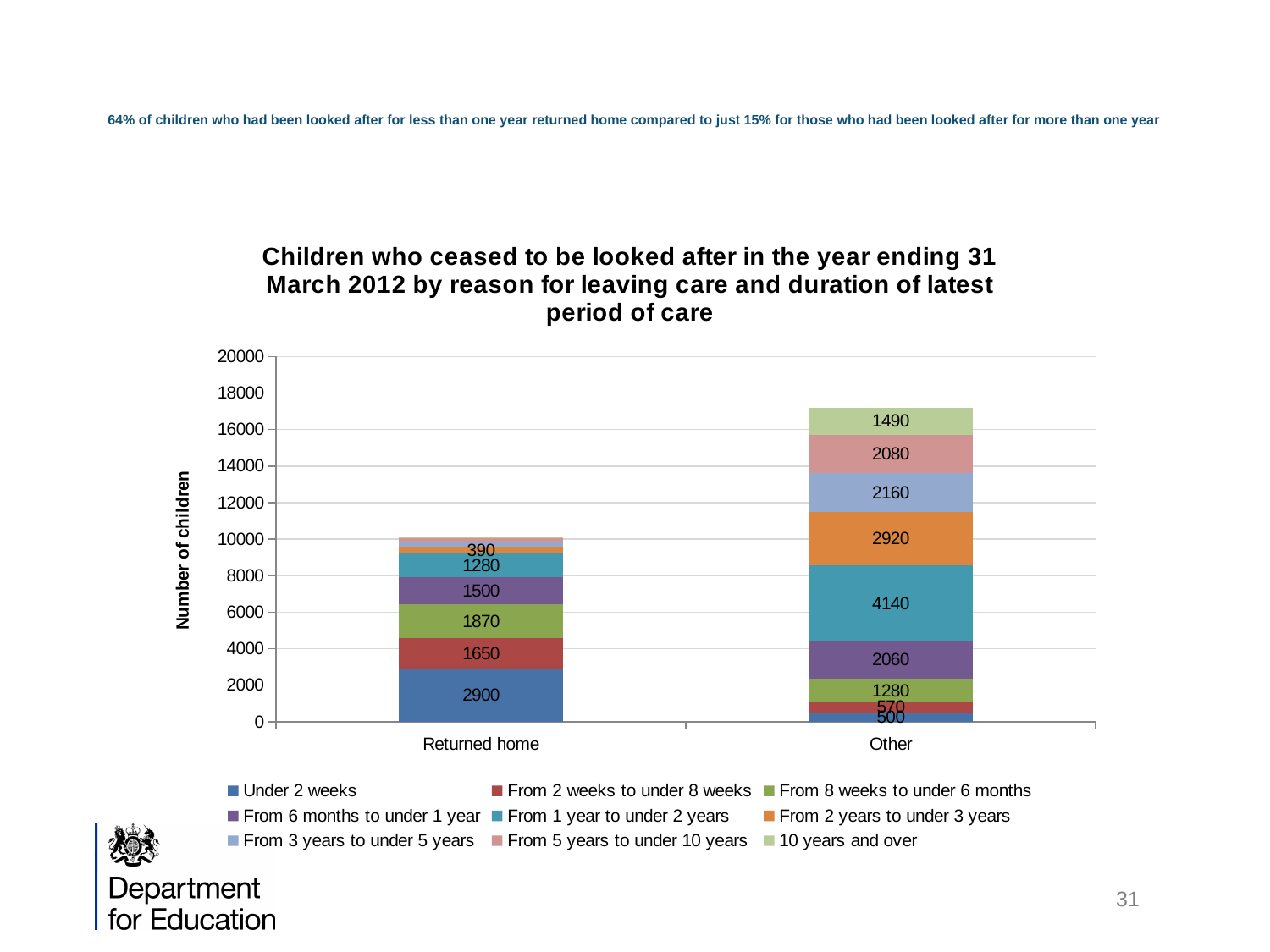
What kind of chart is shown on the slide? Stacked bar chart How many series does the legend list? 9 How many categories are shown on the x axis? 2 Which category has the larger value for 'From 8 weeks to under 6 months', 'Returned home' or 'Other'? Returned home What is the total of the 'Other' stacked bar? 17200 What is the value for 'Under 2 weeks' in the 'Returned home' bar? 2900 What is the difference between the 'From 2 years to under 3 years' values for 'Other' and 'Returned home'? 2530 What is the value for 'From 1 year to under 2 years' in the 'Other' bar? 4140 What is the difference between the 'Under 2 weeks' values for 'Returned home' and 'Other'? 2400 Is the total height of the 'Returned home' bar greater or less than 12000? less Within the 'Other' bar, which duration segment has the largest value? From 1 year to under 2 years What is the value for '10 years and over' in the 'Other' bar? 1490